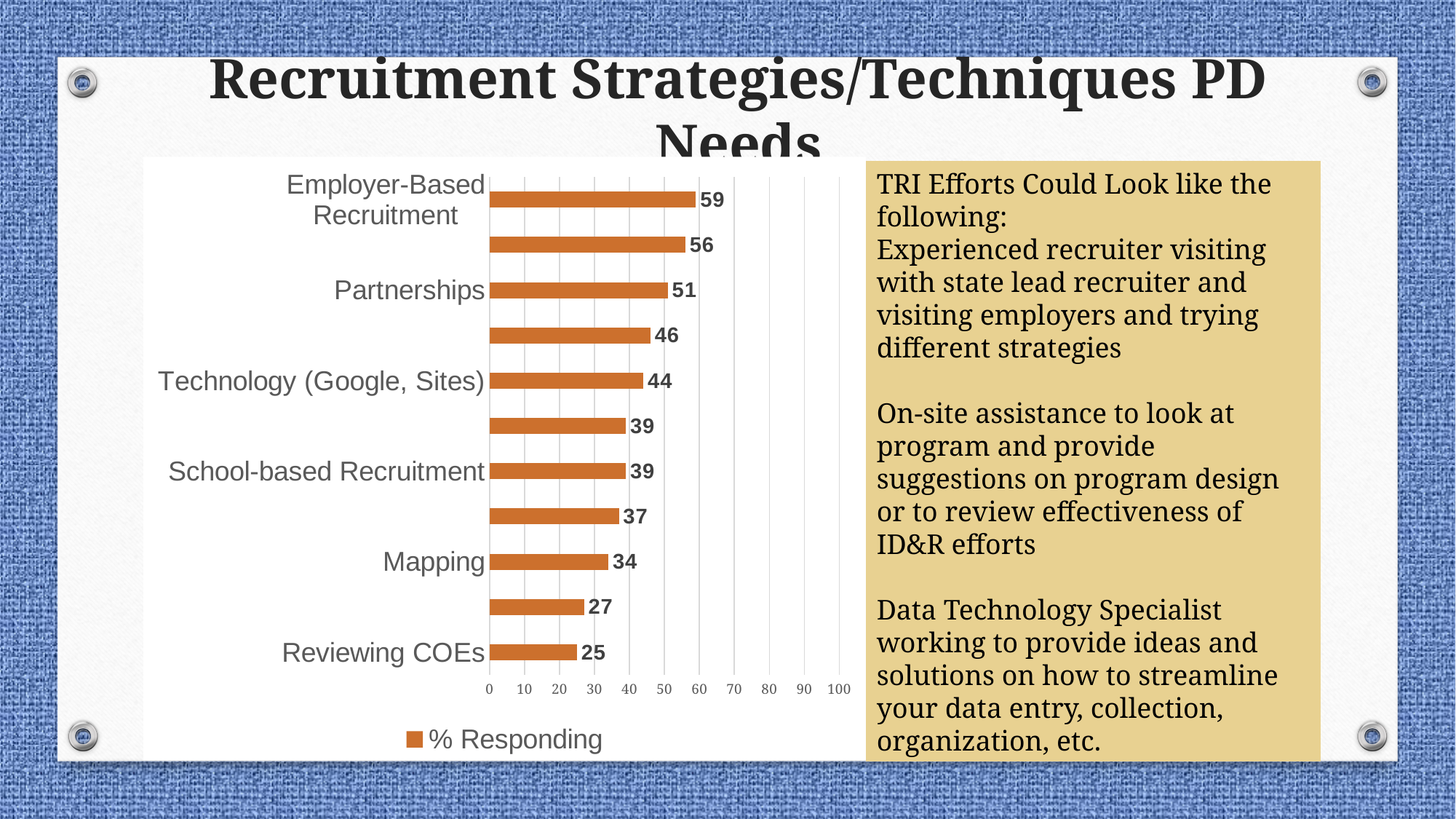
How many bars are plotted in the chart? 11 What is the value for Employer-Based Recruitment? 59 Which is larger, the value for Partnerships or the value for School-based Recruitment? Partnerships What kind of chart is shown on the slide? Bar chart What series name does the legend show? % Responding What is the value for Reviewing COEs? 25 What is the difference between the values for Employer-Based Recruitment and Reviewing COEs? 34 Which labeled category has the lowest value? Reviewing COEs Which labeled category has the highest value? Employer-Based Recruitment What is the value for Mapping? 34 What is the value for Partnerships? 51 What is the value for Technology (Google, Sites)? 44